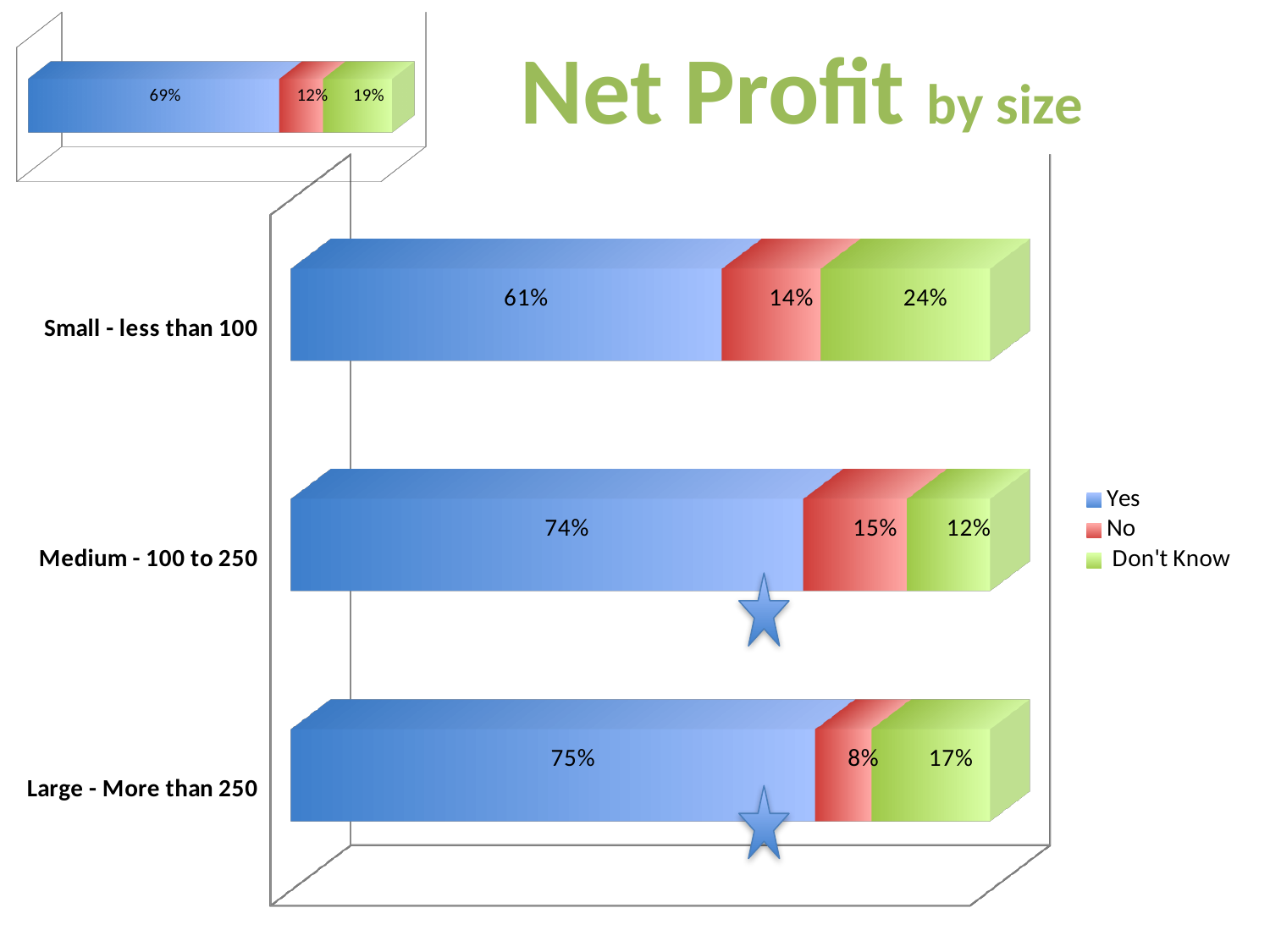
In the Net Profit by size chart, what is the Don't Know value for Medium - 100 to 250? 12% In the Net Profit by size chart, how many size categories are shown? 3 In the Net Profit by size chart, what percentage of Small (less than 100) respondents answered Yes? 61% In the Net Profit by size chart, which size category has the lowest Yes percentage? Small - less than 100 In the Net Profit by size chart, how much higher is the Yes percentage for Large - More than 250 than for Small - less than 100? 14% In the Net Profit by size chart, which size category has the highest Don't Know percentage? Small - less than 100 In the Net Profit by size chart, which colour represents the Don't Know series? Green In the Net Profit by size chart, which is larger: the No value for Medium - 100 to 250 or the No value for Large - More than 250? Medium - 100 to 250 In the Net Profit by size chart, what is the No value for Large - More than 250? 8% In the small chart at the top left of the slide, what is the value of the blue segment? 69% In the Net Profit by size chart, how many series does the legend list? 3 What type of chart is the Net Profit by size chart? Stacked bar chart